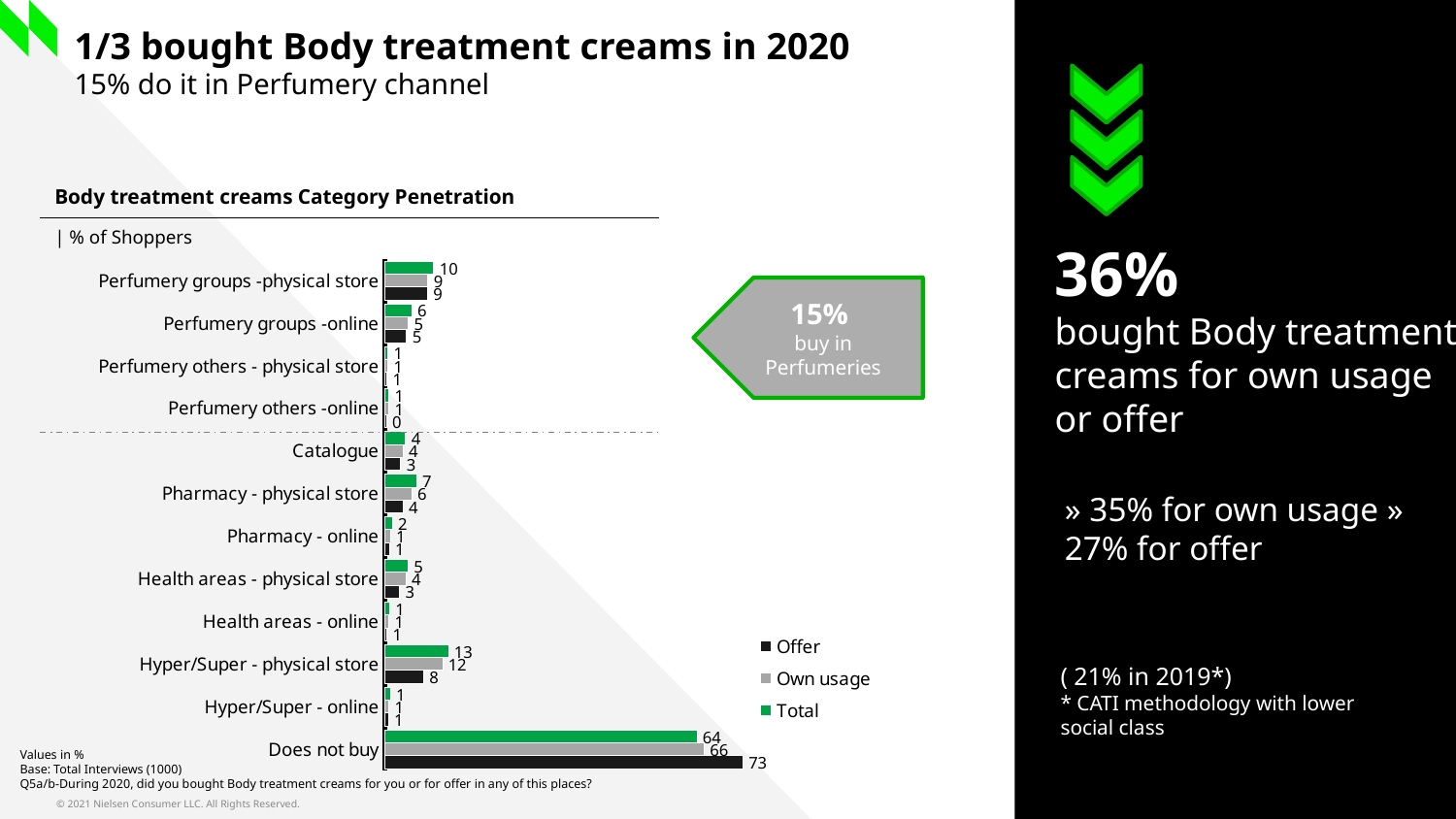
Which category has the highest Total value? Does not buy What is the Own usage value for Pharmacy - physical store? 6 What kind of chart is shown on the slide? bar chart What is the difference between the Total and Own usage values for Does not buy? 7 How many series does the legend of the Body treatment creams Category Penetration chart list? 3 What is the difference between the Offer and Total values for Hyper/Super - physical store? 5 What is the Total value for Does not buy? 73 What is the Total value for Perfumery others - online? 0 How many categories are plotted on the Body treatment creams Category Penetration chart? 12 Which has the larger Offer value: Perfumery groups - physical store or Pharmacy - physical store? Perfumery groups - physical store What are the three legend entries of the chart? Offer, Own usage, Total What is the Offer value for Hyper/Super - physical store? 13